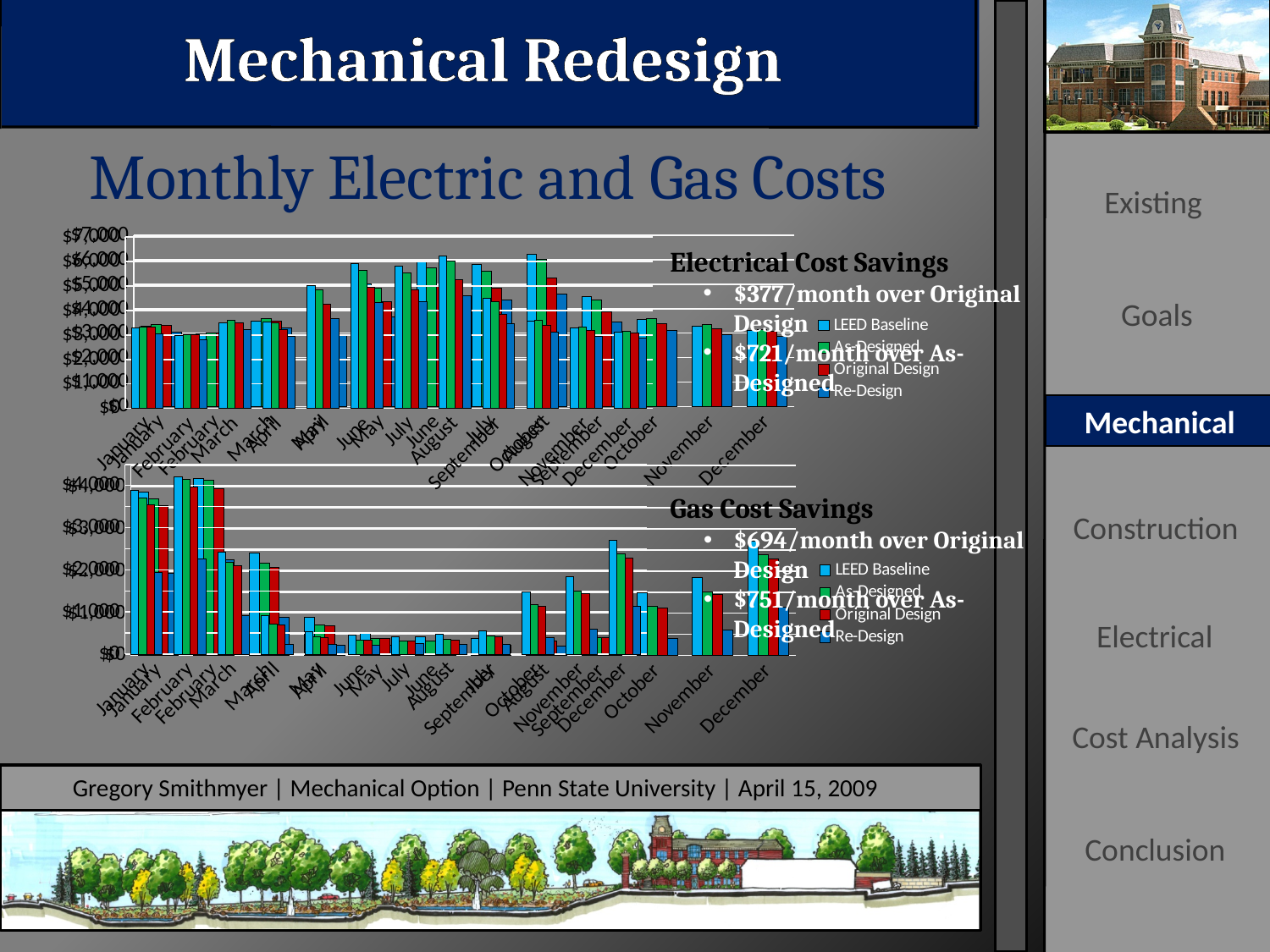
What kind of chart is the bottom chart (gas costs) on the slide? Bar chart In the top chart (electric costs), which month has the larger LEED Baseline value, June or February? June In the bottom chart (gas costs), is the LEED Baseline value for July greater or less than $10,000? less In the top chart (electric costs), do the values rise or fall from February to June? Rise According to the text on the top chart, what is the electrical cost savings per month over the As-Designed case? $721/month In the bottom chart (gas costs), do the values rise or fall from February to July? Fall In the bottom chart (gas costs), which month has the larger LEED Baseline value, January or July? January How many series does the legend of the top chart list? 4 What are the four series named in the legend of the bottom chart? LEED Baseline, As-Designed, Original Design, Re-Design What kind of chart is the top chart (electric costs) on the slide? Bar chart How many months are shown along the x axis of the bottom chart? 12